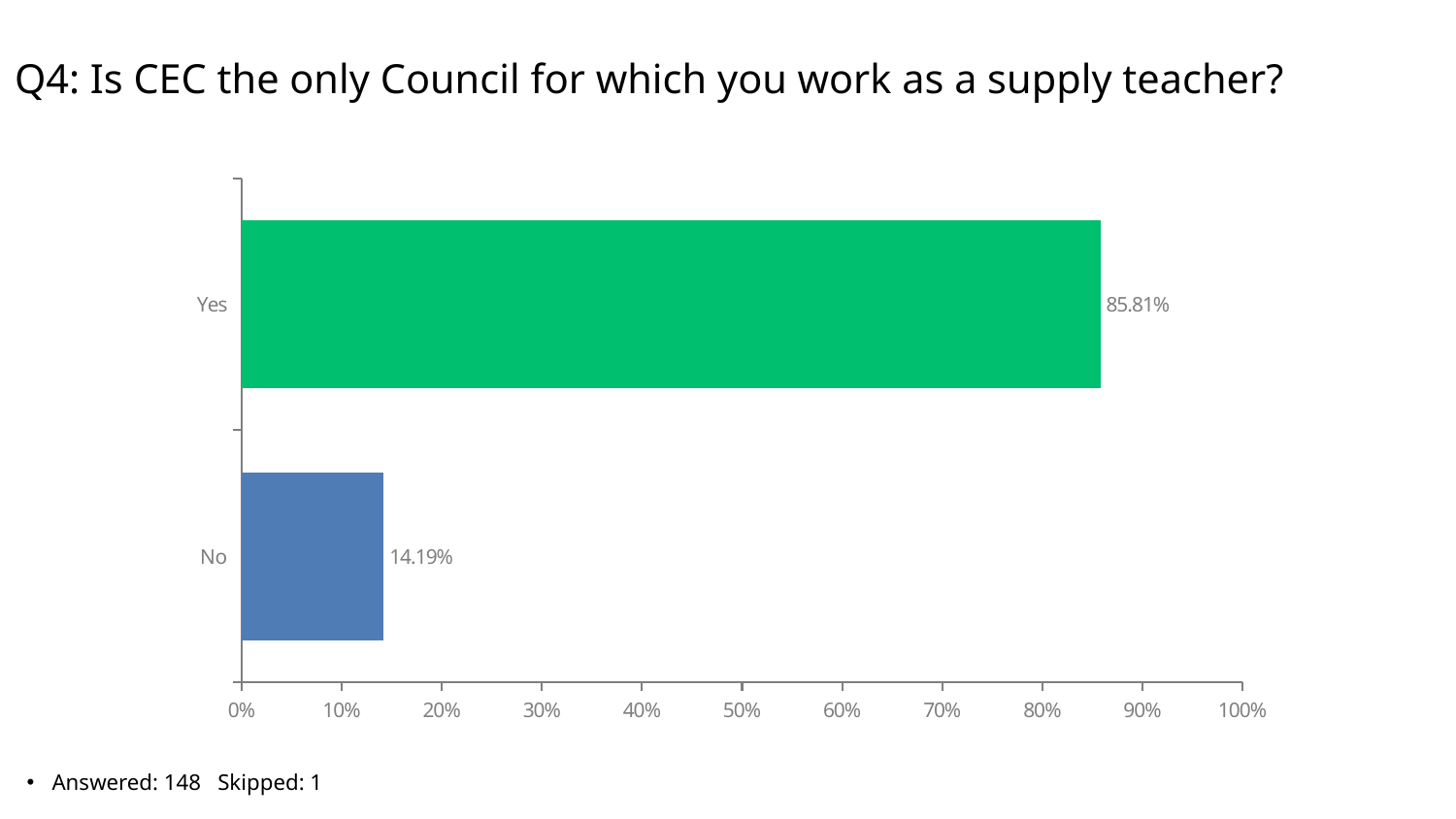
How many response categories are shown in the chart? 2 Which response is larger, Yes or No? Yes What percentage of respondents answered No? 14.19% Which response has the highest percentage? Yes Is the value for Yes greater or less than 80%? greater Is the value for No greater or less than 20%? less Which response has the lowest percentage? No What is the title of the chart? Q4: Is CEC the only Council for which you work as a supply teacher? What percentage of respondents answered Yes? 85.81% What colour is the bar for the Yes response? Green What is the difference in percentage points between the Yes and No responses? 71.62 What kind of chart is shown on the slide? Bar chart